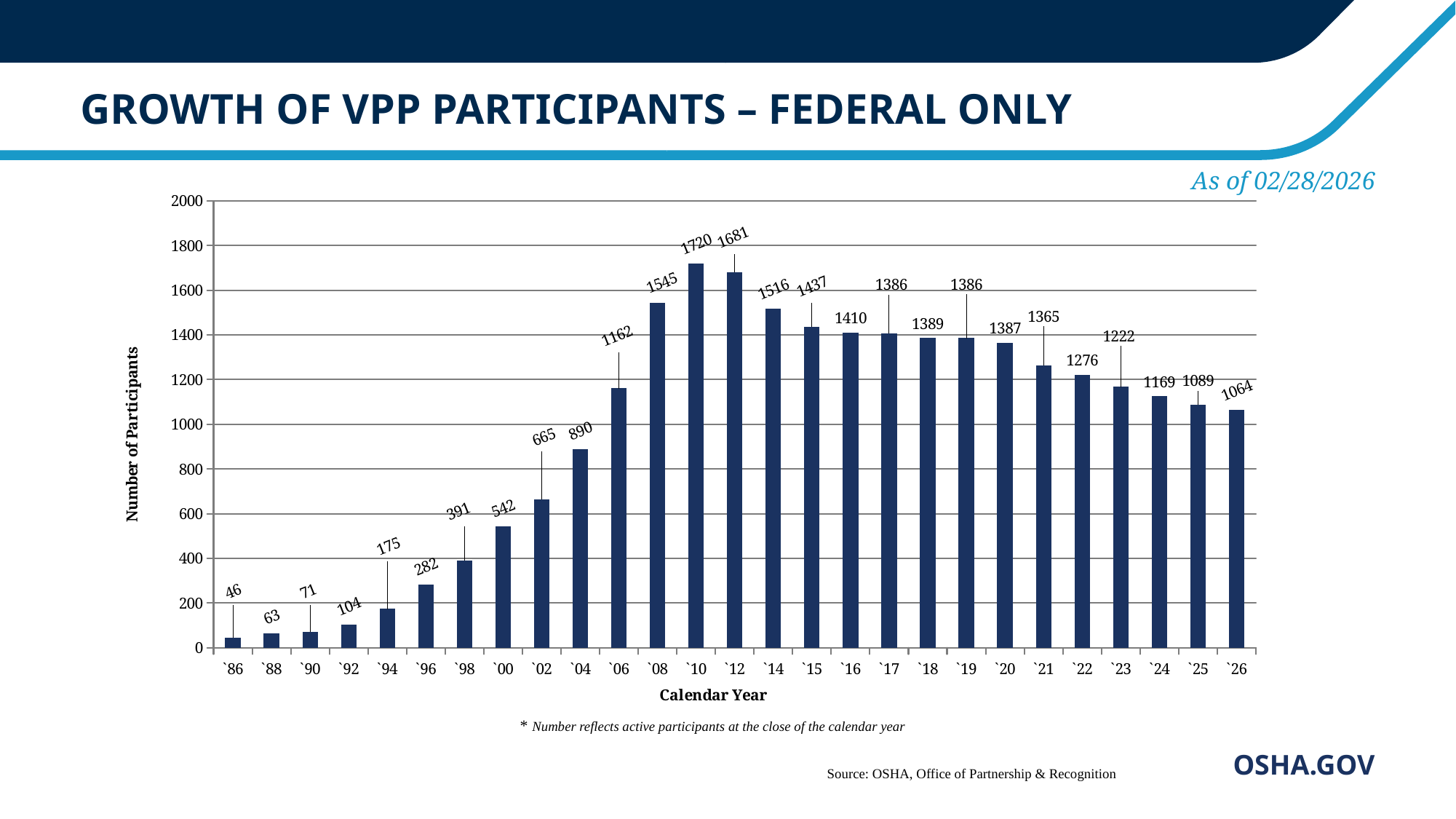
Is the value for `06 greater or less than 1000? greater What is the difference in participants between `08 and `06? 383 What kind of chart is shown on the slide? Bar chart What is the number of participants for `10? 1720 How many calendar years are plotted on the chart? 27 What is the number of participants for `98? 391 What is the number of participants for `26? 1064 Which calendar year has the lowest number of participants? `86 What is the difference in participants between `10 and `26? 656 Which year has more participants, `12 or `14? `12 Do the values rise or fall from `10 to `26? Fall Which calendar year has the highest number of participants? `10